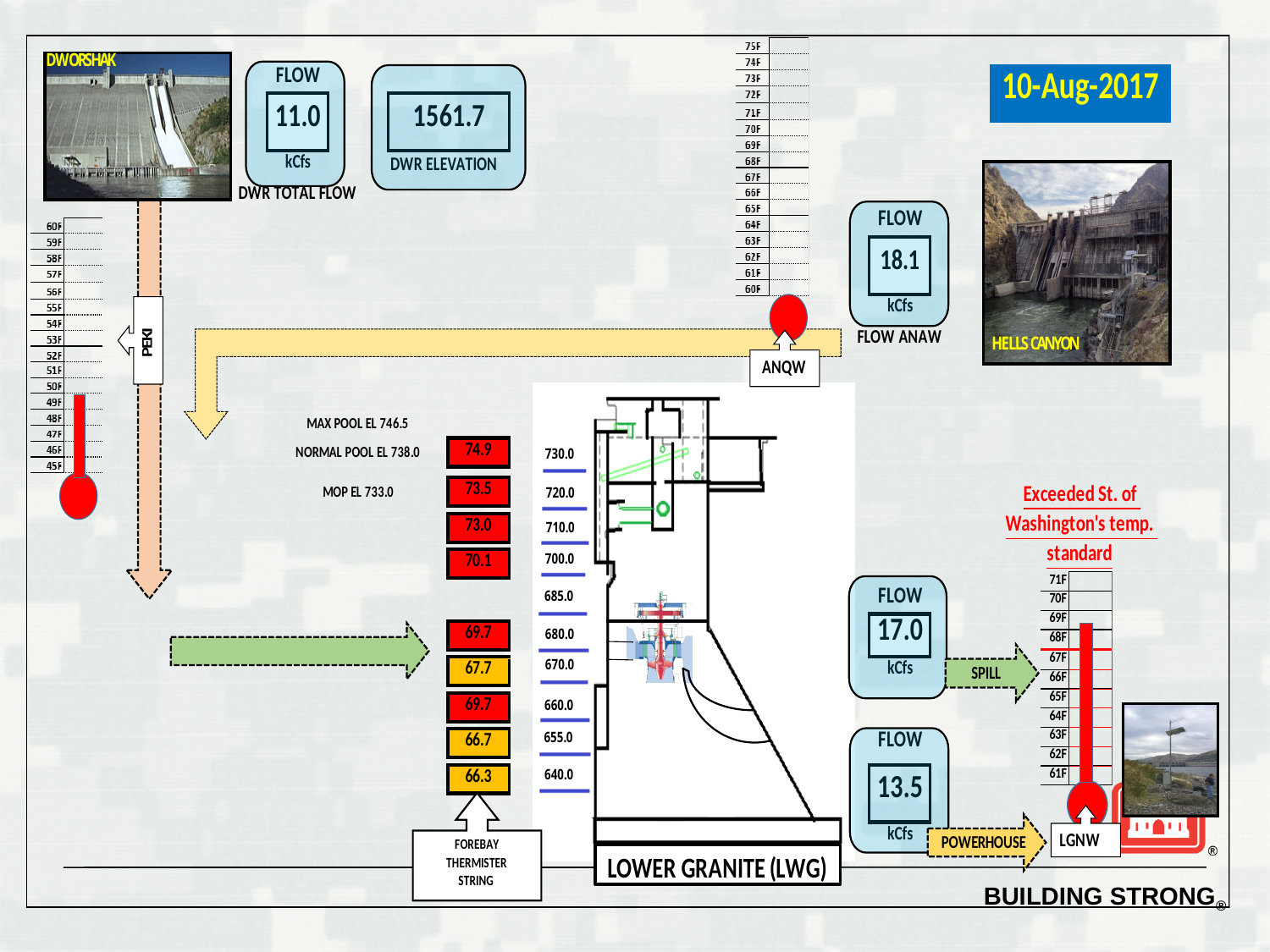
What DWR elevation value is shown on the slide? 1561.7 On the LGNW thermometer gauge at the right, is the red fill level greater or less than 65F? greater Which is larger at Lower Granite, the SPILL flow or the POWERHOUSE flow? SPILL What is the difference between the topmost (74.9) and bottommost (66.3) readings in the forebay thermistor string? 8.6 What is the difference between the SPILL flow (17.0 kCfs) and the POWERHOUSE flow (13.5 kCfs) at Lower Granite? 3.5 kCfs What date is shown in the blue box at the top right of the slide? 10-Aug-2017 What is the FLOW ANAW value shown in the gauge near the Hells Canyon photo? 18.1 kCfs In the forebay thermistor string on the Lower Granite (LWG) diagram, what is the highest temperature reading shown? 74.9 In the forebay thermistor string on the Lower Granite (LWG) diagram, what is the lowest temperature reading shown? 66.3 What is the DWR total flow value shown in the FLOW gauge next to the Dworshak photo? 11.0 kCfs What is the topmost reading in the forebay thermistor string column? 74.9 How many temperature readings are shown in the forebay thermistor string column? 9